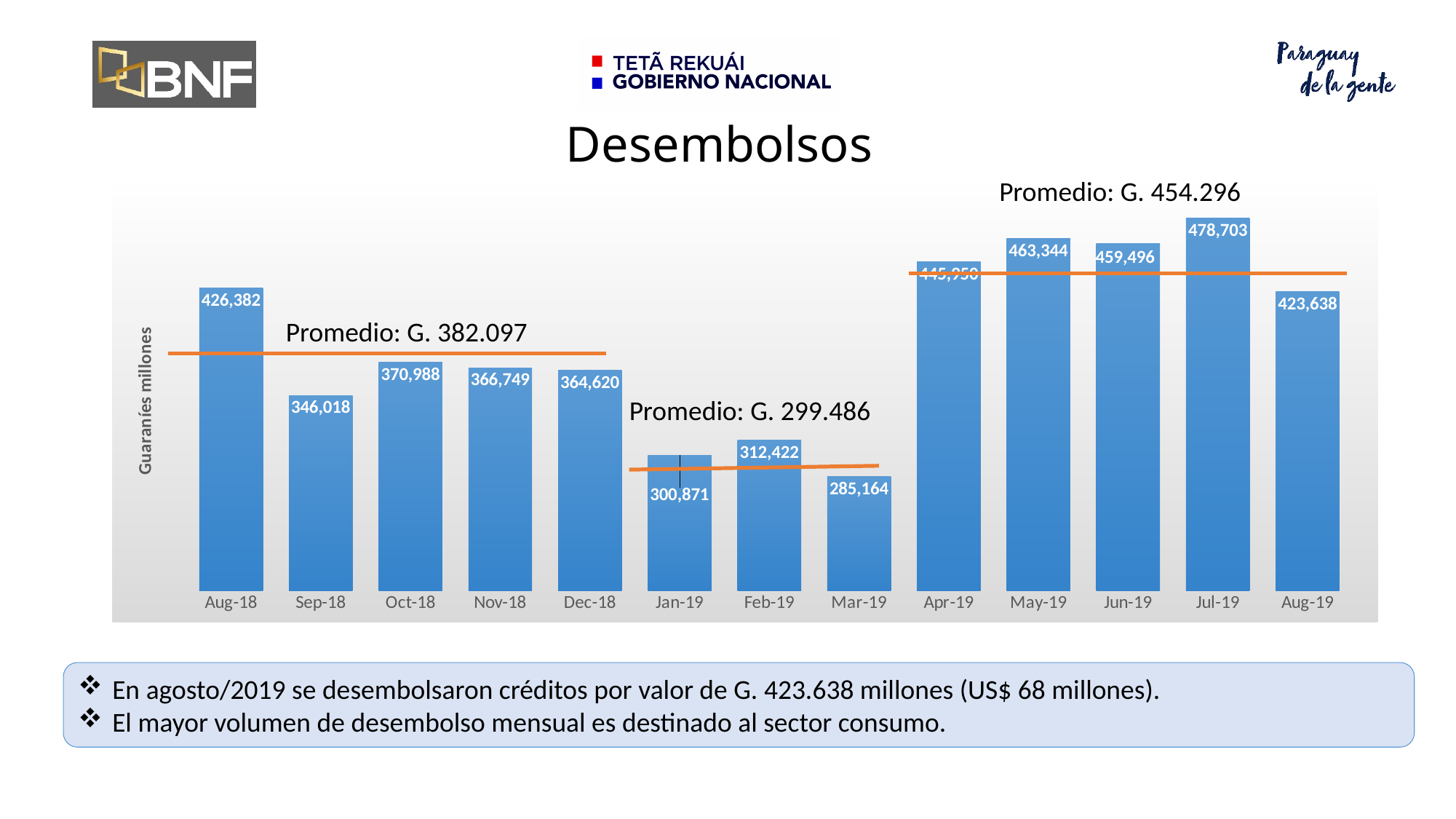
What is the value for Mar-19? 285,164 Which is larger, the value for Aug-18 or the value for Aug-19? Aug-18 How many months are shown on the x axis? 13 What is the value for Jul-19? 478,703 What is the value for Sep-18? 346,018 Which month has the lowest value? Mar-19 What is the difference between the values for Jul-19 and Aug-19? 55,065 What is the value for Aug-19? 423,638 Which month has the highest value? Jul-19 What is the difference between the values for Feb-19 and Jan-19? 11,551 What is the title of the chart? Desembolsos What kind of chart is shown on the slide? Bar chart